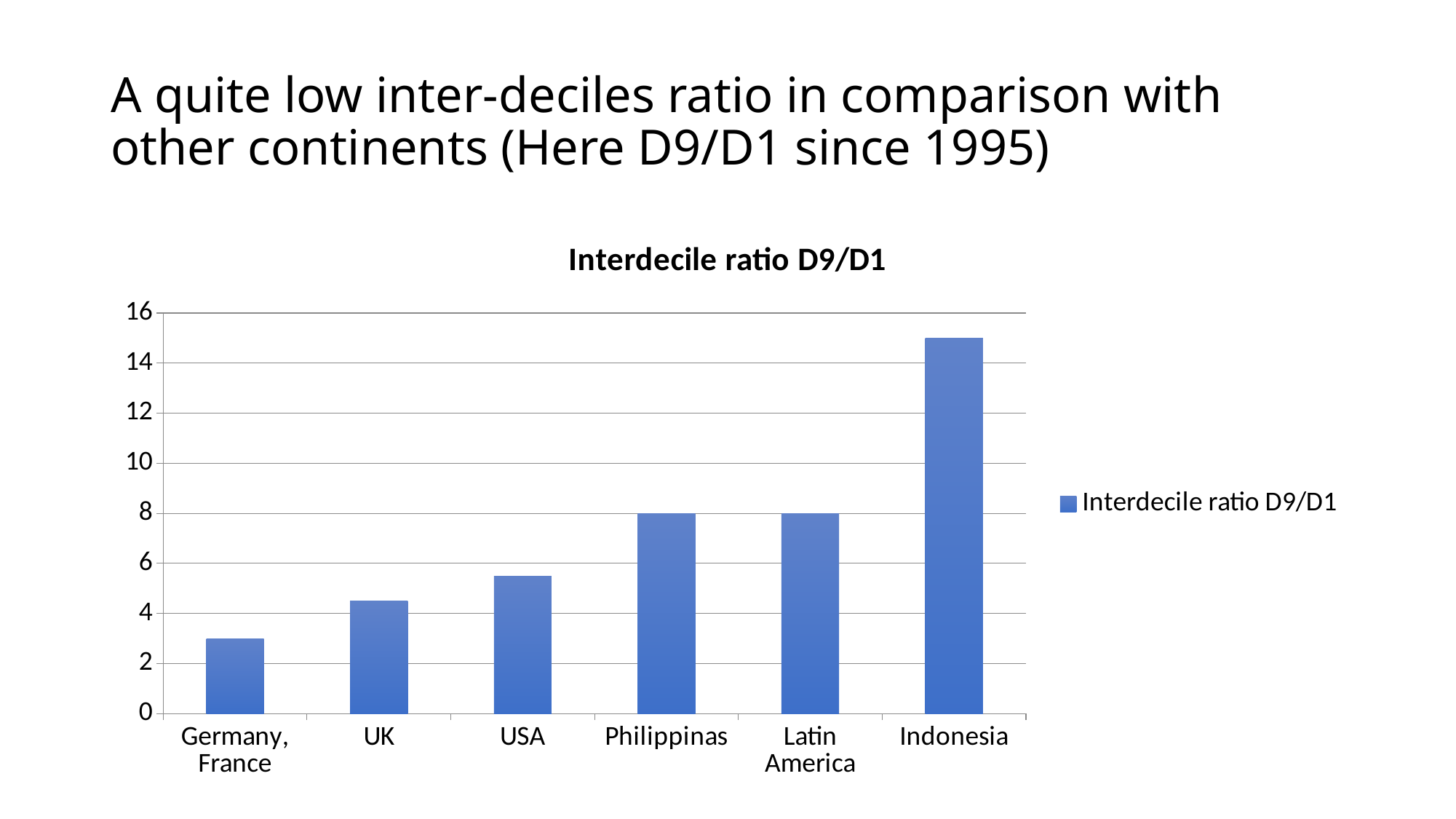
Which has a larger interdecile ratio D9/D1, USA or Indonesia? Indonesia Which category has the highest interdecile ratio D9/D1? Indonesia What kind of chart is shown on the slide? Bar chart Is the value for USA greater or less than 6? less How many categories are shown on the x axis of the chart? 6 What is the title of the chart? Interdecile ratio D9/D1 What is the interdecile ratio D9/D1 for Philippinas? 8 Is the value for Indonesia greater or less than 14? greater Which category has the lowest interdecile ratio D9/D1? Germany, France Is the value for Germany, France greater or less than 4? less How many series does the legend list? 1 What is the interdecile ratio D9/D1 for Latin America? 8